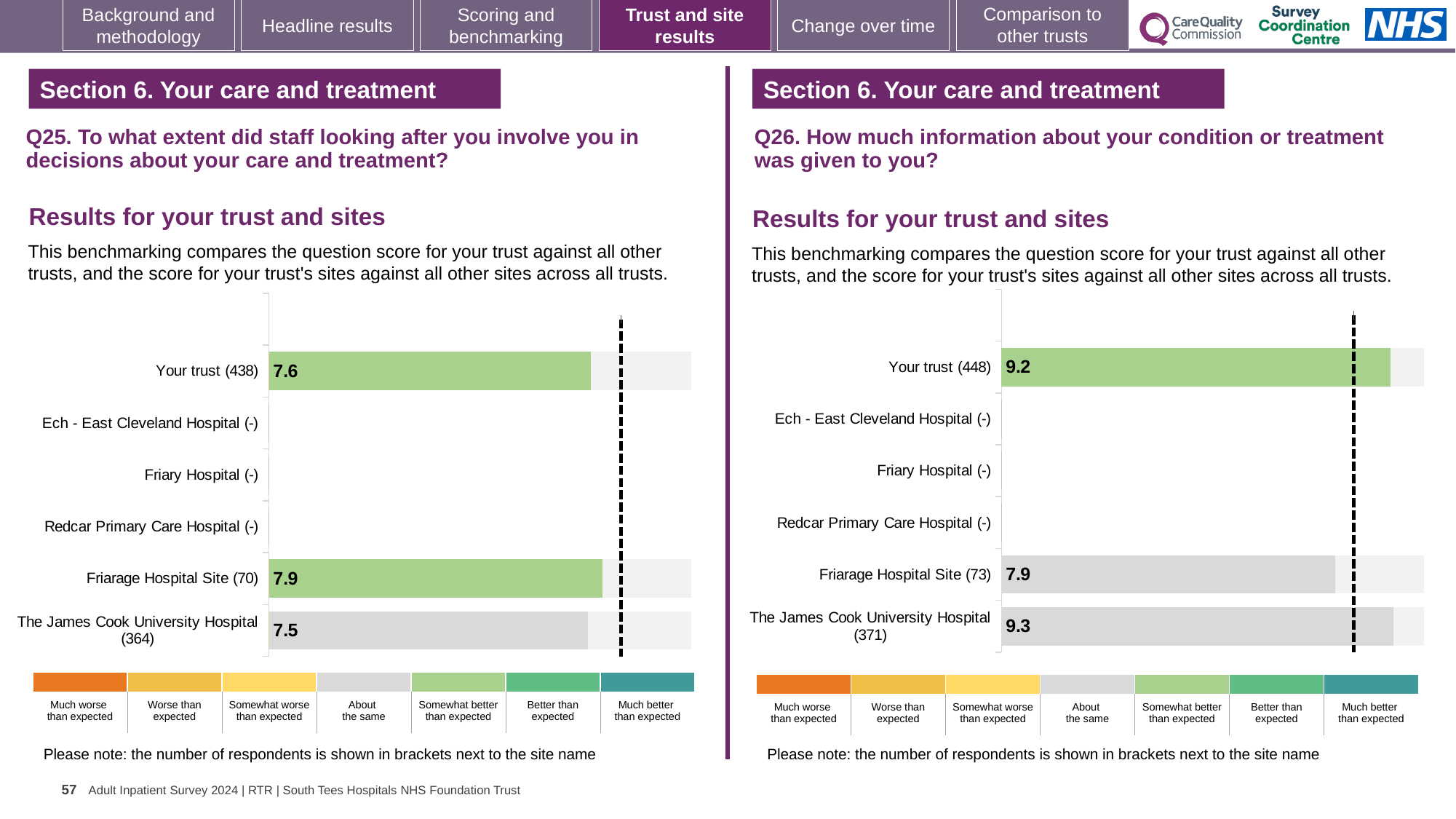
In the Q25 chart on the left, what is the score for Your trust? 7.6 In the Q25 chart on the left, what is the difference between the Friarage Hospital Site score and The James Cook University Hospital score? 0.4 In the Q26 chart on the right, what is the score for The James Cook University Hospital? 9.3 In the Q26 chart on the right, which has the larger score, Your trust or Friarage Hospital Site? Your trust In the Q26 chart on the right, what is the score for Your trust? 9.2 In the Q26 chart on the right, what is the difference between The James Cook University Hospital score and the Friarage Hospital Site score? 1.4 In the Q25 chart on the left, which site or trust has the highest score? Friarage Hospital Site In the Q26 chart on the right, which site or trust has the lowest score? Friarage Hospital Site In the Q26 chart on the right, what is the score for Friarage Hospital Site? 7.9 In the Q25 chart on the left, what is the score for Friarage Hospital Site? 7.9 What kind of chart is used in the Q25 chart on the left? Bar chart In the Q25 chart on the left, what is the score for The James Cook University Hospital? 7.5